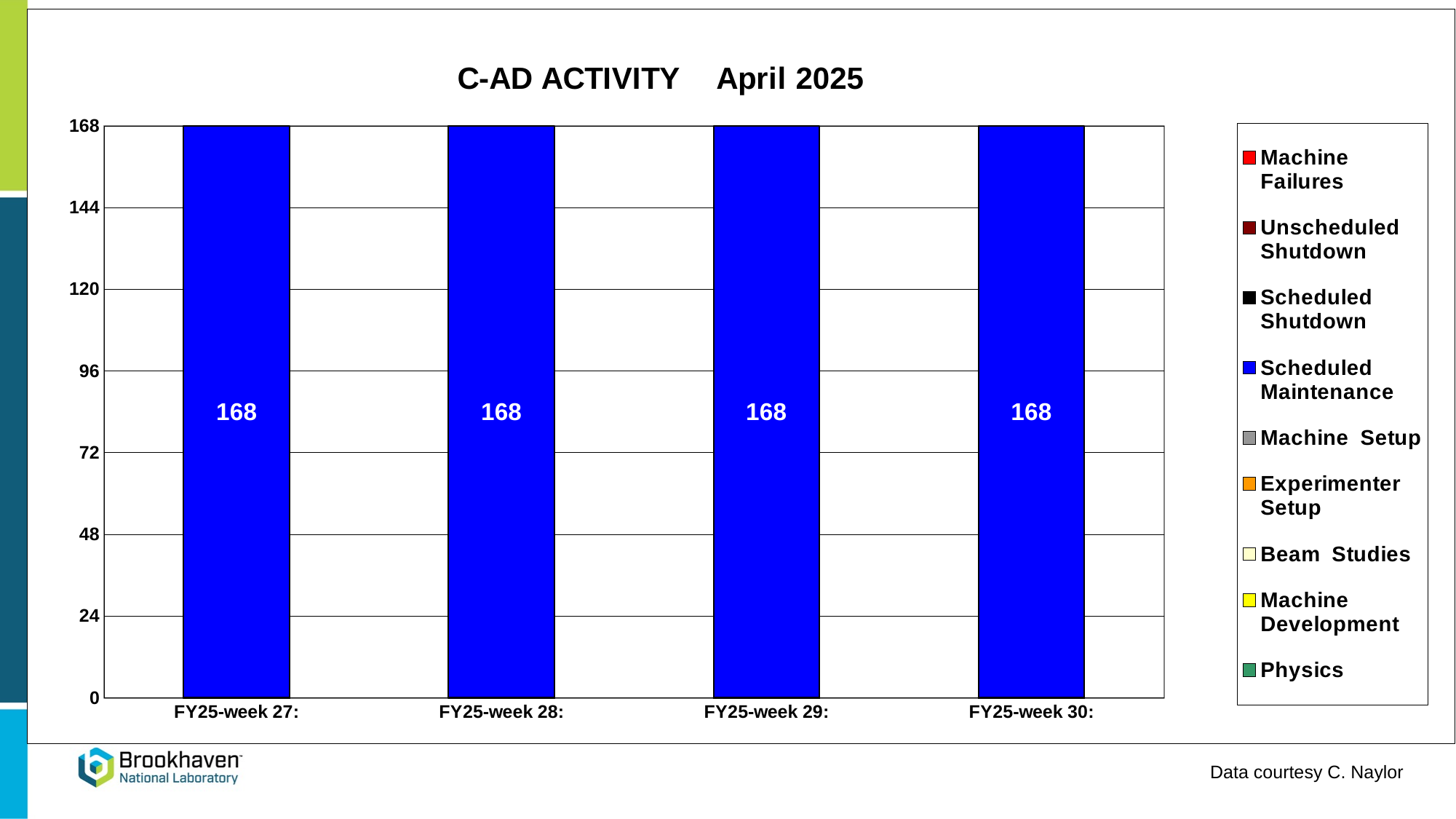
What is the title of the chart? C-AD ACTIVITY April 2025 What is the value of Scheduled Maintenance for FY25-week 27? 168 What kind of chart is shown on the slide? bar chart What is the difference between the values for FY25-week 28 and FY25-week 29? 0 Is the value for FY25-week 28 greater or less than 144? greater What is the total of the stacked bar for FY25-week 30? 168 What is the value shown on the bar for FY25-week 29? 168 What is the value of Scheduled Maintenance for FY25-week 30? 168 Which legend series is shown in blue? Scheduled Maintenance How many weeks (categories) are shown on the x axis? 4 How many series does the legend list? 9 Do the values rise, fall, or stay the same from FY25-week 27 to FY25-week 30? stay the same